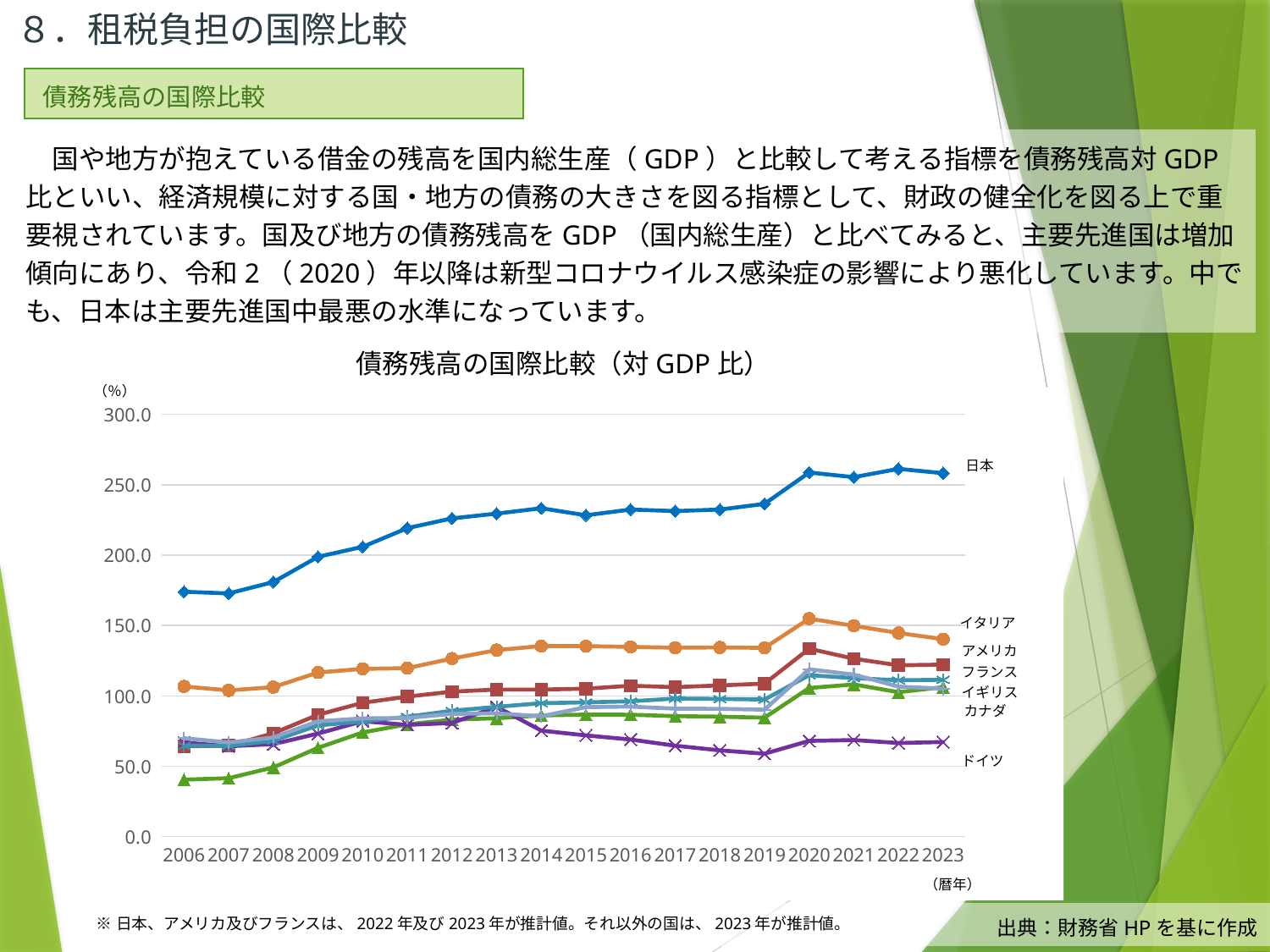
In 2023, which is larger: the value for イタリア or the value for アメリカ? イタリア Which country has the lowest debt-to-GDP ratio in 2023? ドイツ Is the value for 日本 in 2023 greater or less than 250? greater Which country has the lowest value in 2006? イギリス How many countries are plotted in the chart 債務残高の国際比較（対GDP比）? 7 Does the line for 日本 rise or fall from 2006 to 2023? rise What unit is shown on the y axis of the chart? (%) Is the value for ドイツ in 2023 greater or less than 100? less Is the value for 日本 in 2006 greater or less than 150? greater What kind of chart is shown on the slide? line chart Which country has the highest debt-to-GDP ratio in 2023? 日本 How many years are shown on the x axis of the chart? 18